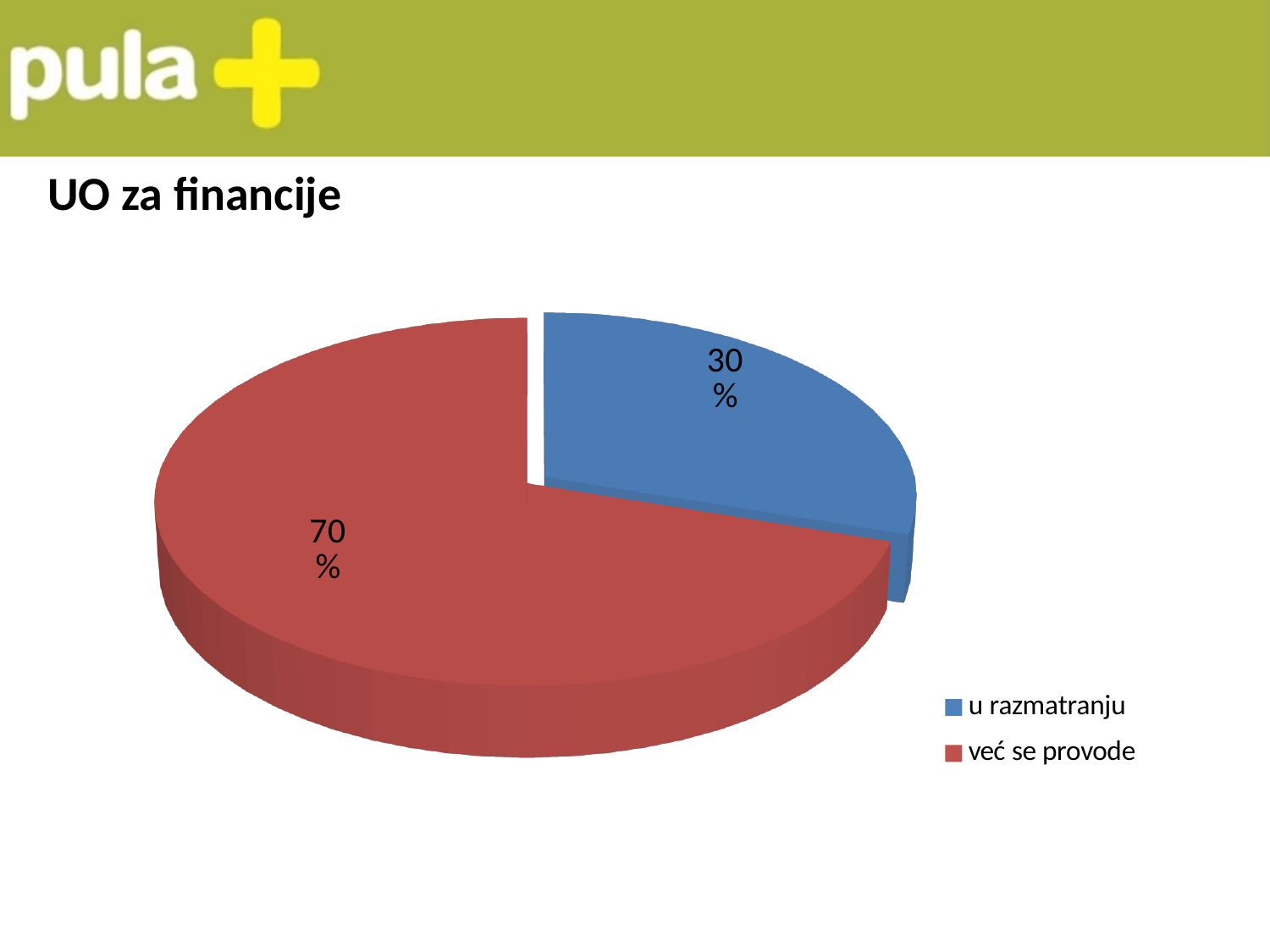
What colour is the "u razmatranju" slice? blue What is the title shown above the chart? UO za financije What is the difference in percentage points between "već se provode" and "u razmatranju"? 40 What share of the pie does "već se provode" have? 70% How many slices does the pie chart have? 2 What kind of chart is shown on the slide? pie chart What share of the pie does "u razmatranju" have? 30% How many entries does the legend list? 2 Which is larger, "u razmatranju" or "već se provode"? već se provode Which slice is the largest? već se provode Which slice is the smallest? u razmatranju